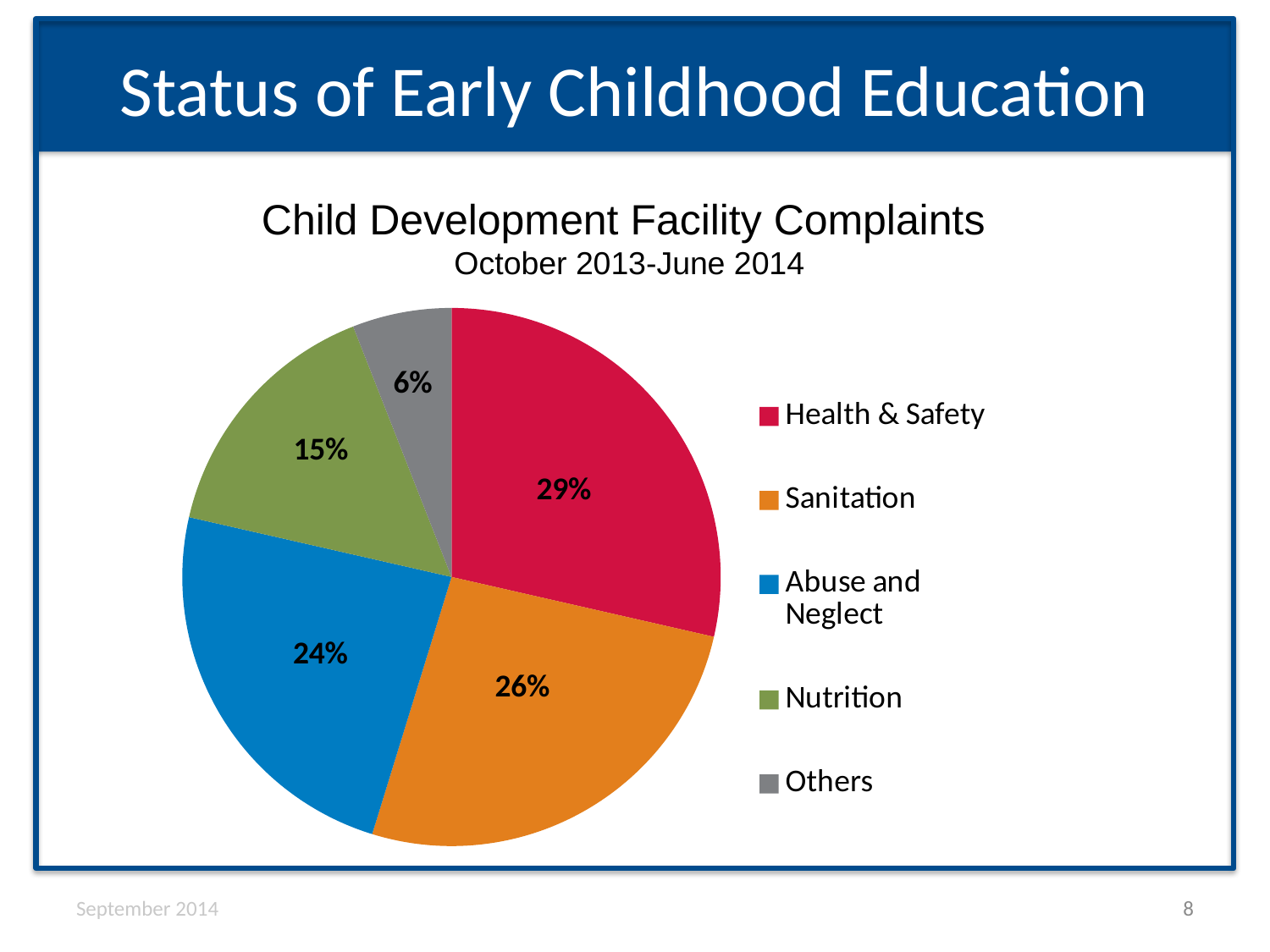
Which has a larger share, Sanitation or Abuse and Neglect? Sanitation What is the difference in percentage points between Health & Safety and Nutrition? 14 What is the title of the chart? Child Development Facility Complaints October 2013-June 2014 What share of complaints is Others? 6% What kind of chart is shown on the slide? Pie chart How many categories does the pie chart show? 5 What share of complaints is Health & Safety? 29% What share of complaints is Nutrition? 15% What share of complaints is Abuse and Neglect? 24% What share of complaints is Sanitation? 26% Which complaint category has the smallest share? Others Which complaint category has the largest share? Health & Safety